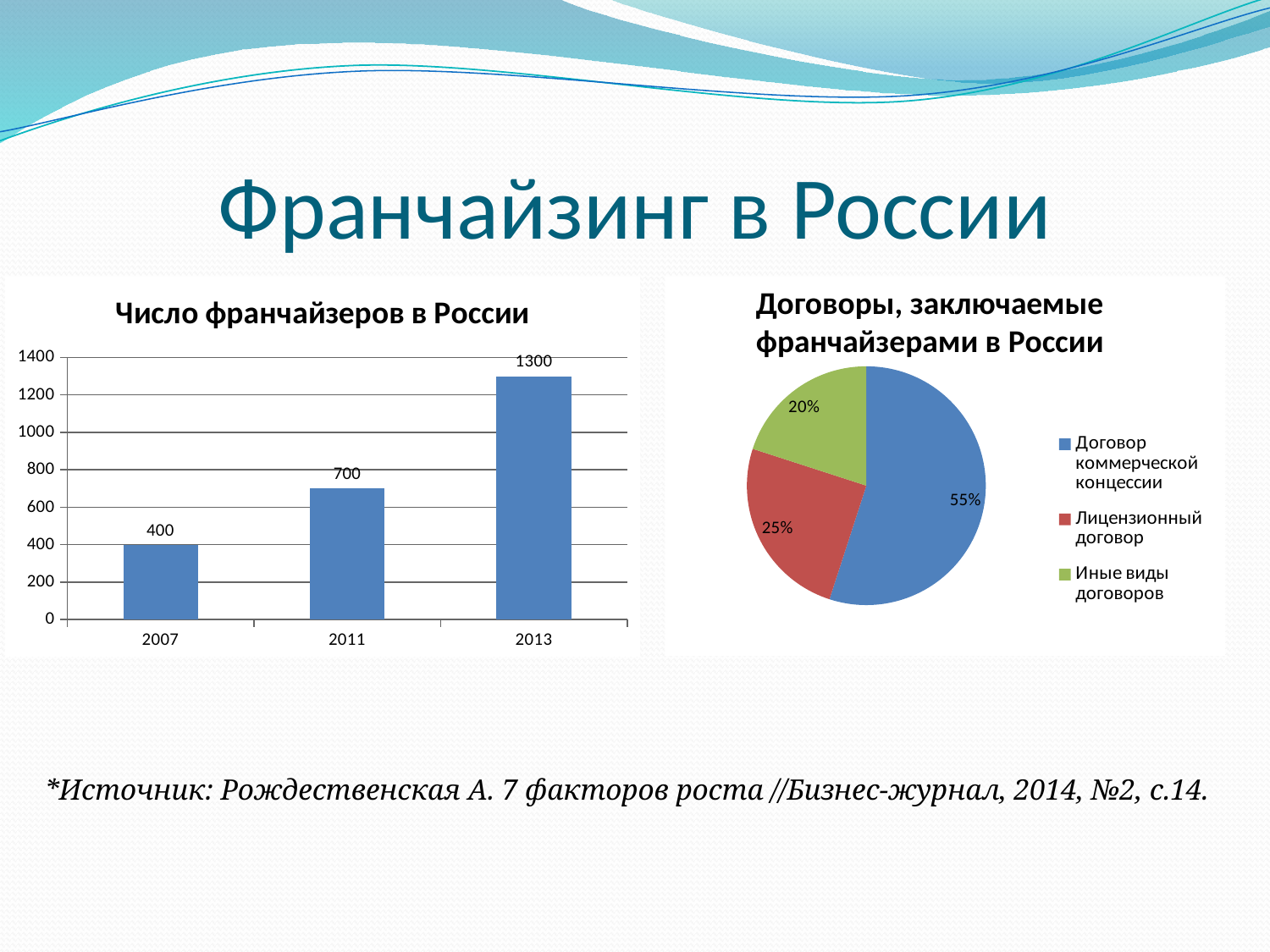
In the chart 'Число франчайзеров в России', what is the value for 2007? 400 In the chart 'Число франчайзеров в России', what is the value for 2011? 700 In the chart 'Число франчайзеров в России', what is the difference between the values for 2013 and 2007? 900 In the chart 'Число франчайзеров в России', how many years are shown on the x axis? 3 In the pie chart 'Договоры, заключаемые франчайзерами в России', what colour is the slice for 'Иные виды договоров'? green In the chart 'Число франчайзеров в России', which year has the lowest value? 2007 In the pie chart 'Договоры, заключаемые франчайзерами в России', how many categories does the legend list? 3 What kind of chart is 'Число франчайзеров в России'? bar chart In the chart 'Число франчайзеров в России', which year has the highest value? 2013 In the pie chart 'Договоры, заключаемые франчайзерами в России', what share is 'Лицензионный договор'? 25% In the chart 'Число франчайзеров в России', do the values rise or fall from 2007 to 2013? rise In the pie chart 'Договоры, заключаемые франчайзерами в России', which category has the largest share? Договор коммерческой концессии